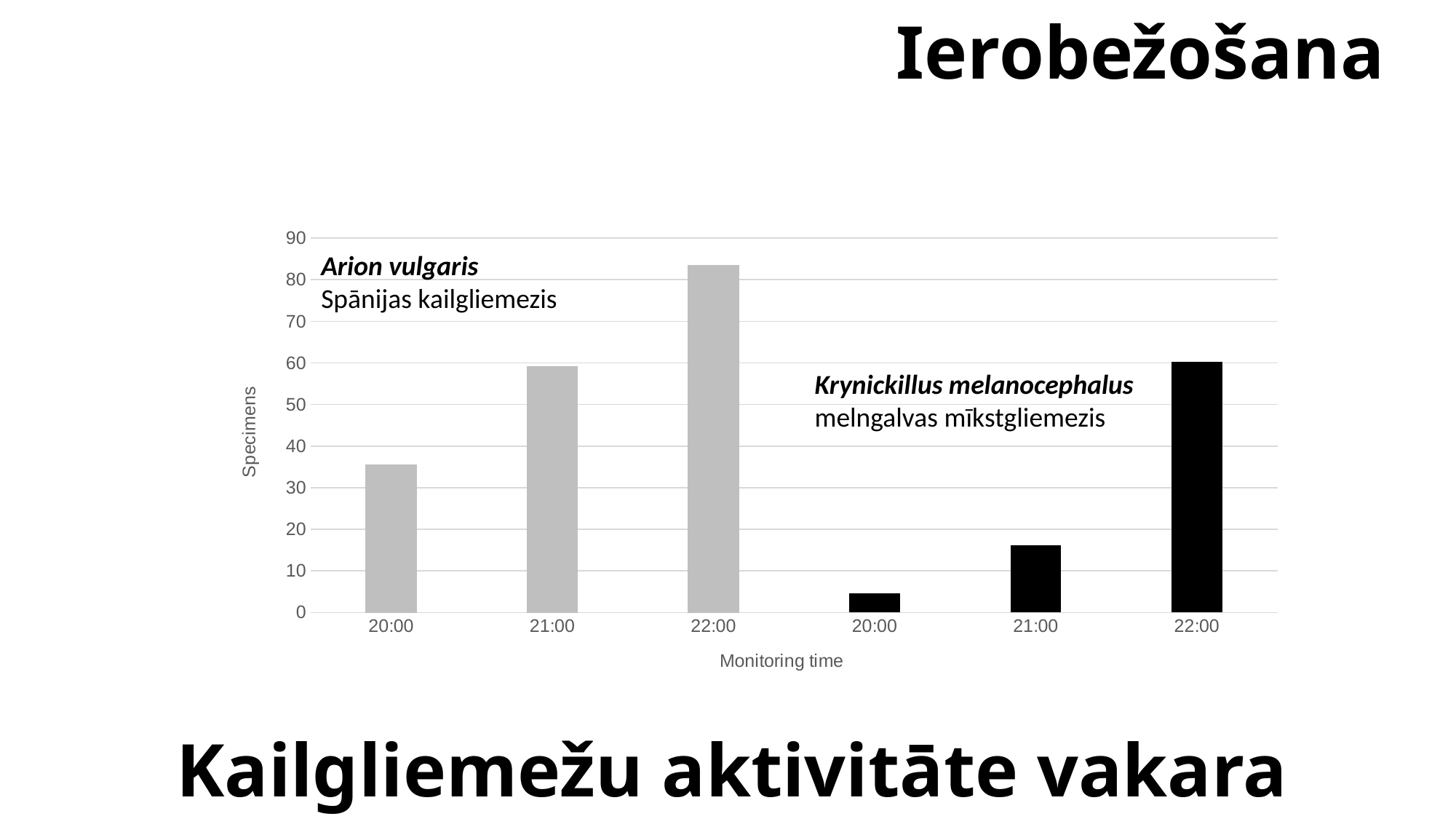
Which monitoring time has the lowest bar for Krynickillus melanocephalus? 20:00 Is the value for Arion vulgaris at 22:00 greater or less than 80? greater Which is larger: Arion vulgaris at 21:00 or Krynickillus melanocephalus at 21:00? Arion vulgaris at 21:00 Is the value for Krynickillus melanocephalus at 20:00 greater or less than 10? less Is the value for Arion vulgaris at 20:00 greater or less than 40? less What is the label of the x axis? Monitoring time Which monitoring time has the highest bar for Arion vulgaris? 22:00 What is the label of the y axis? Specimens How many bars are plotted in the chart? 6 What kind of chart is shown on the slide? bar chart Do the values for Krynickillus melanocephalus rise or fall from 20:00 to 22:00? rise